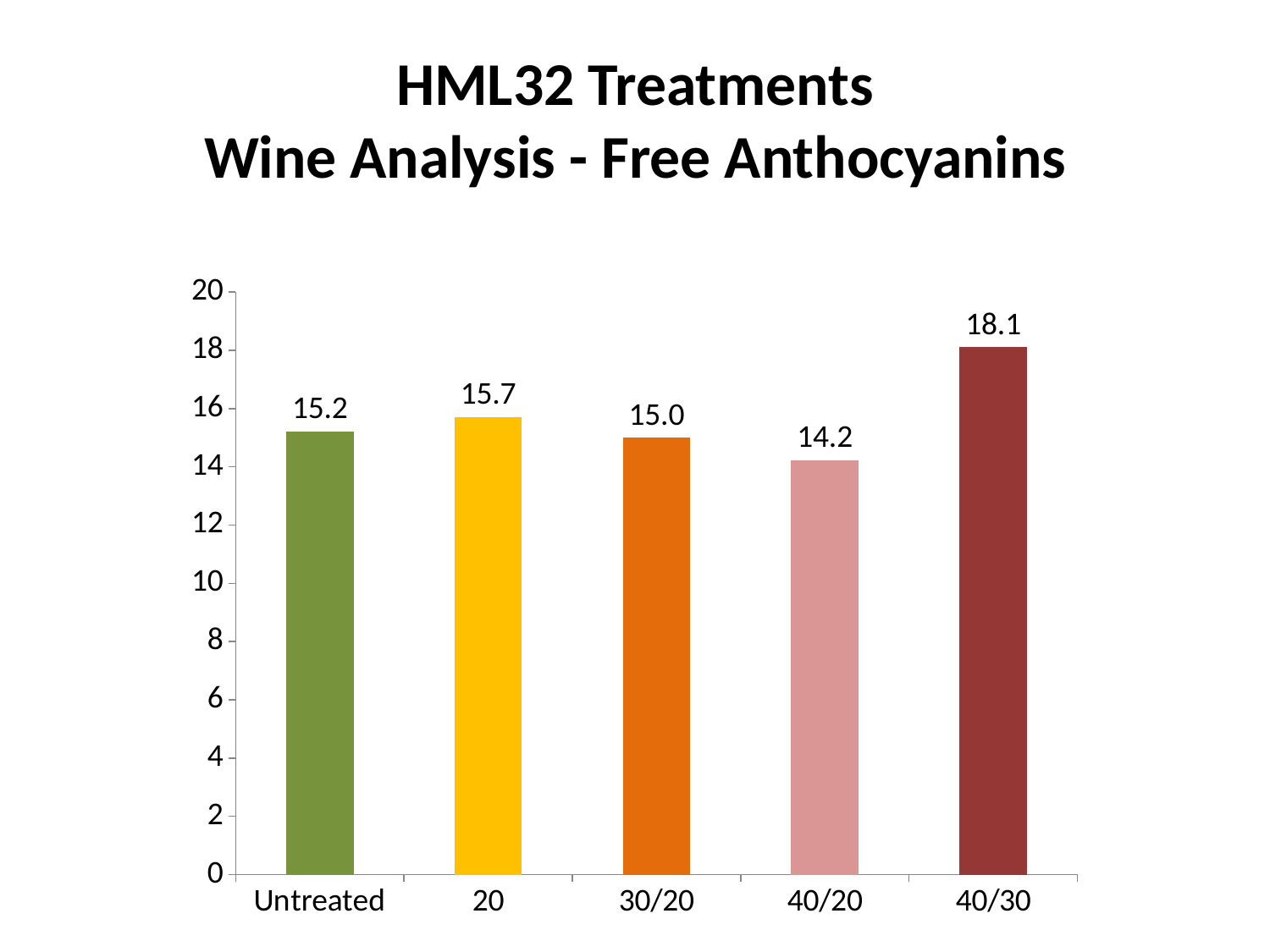
What is the difference between the values for 20 and Untreated? 0.5 What is the title of the chart? HML32 Treatments Wine Analysis - Free Anthocyanins What is the difference between the values for 40/30 and 40/20? 3.9 What is the value for the 40/20 treatment? 14.2 What kind of chart is shown on the slide? bar chart How many categories are shown on the x axis? 5 What is the value for the 40/30 treatment? 18.1 Is the value for 40/30 greater or less than 16? greater What is the value for the Untreated category? 15.2 Which category has the lowest value? 40/20 Which category has the highest value? 40/30 Which is larger, the value for 20 or the value for 30/20? 20